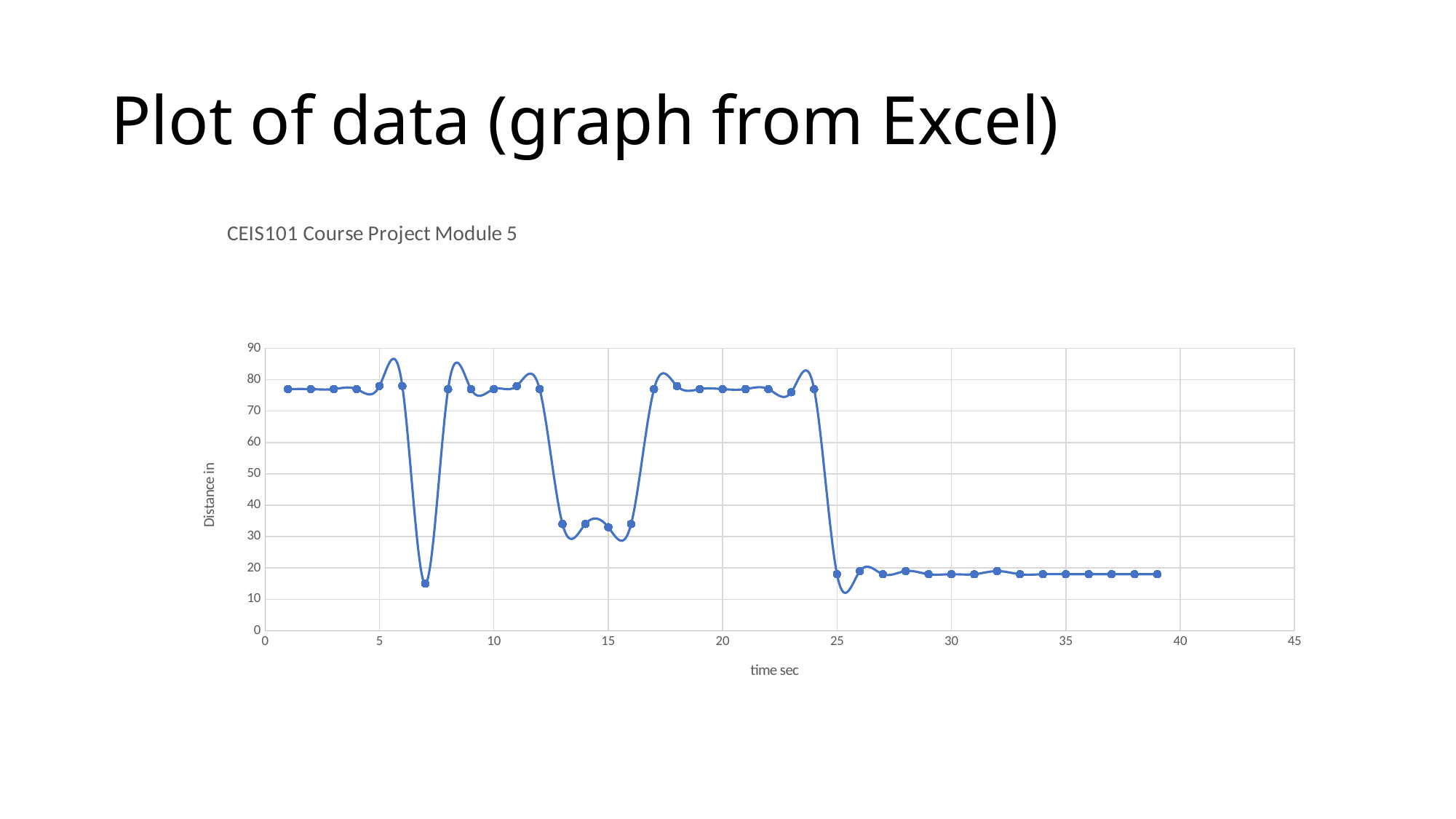
Is the value at time 7 greater or less than 20? less Which is larger, the value at time 1 or the value at time 30? time 1 What is the label on the vertical axis of the chart? Distance in Is the value at time 20 greater or less than 70? greater What is the title of the chart? CEIS101 Course Project Module 5 Is the value at time 13 greater or less than 40? less What kind of chart is shown on the slide? line chart At which time does the lowest value on the chart occur? 7 How many data points are plotted on the chart? 39